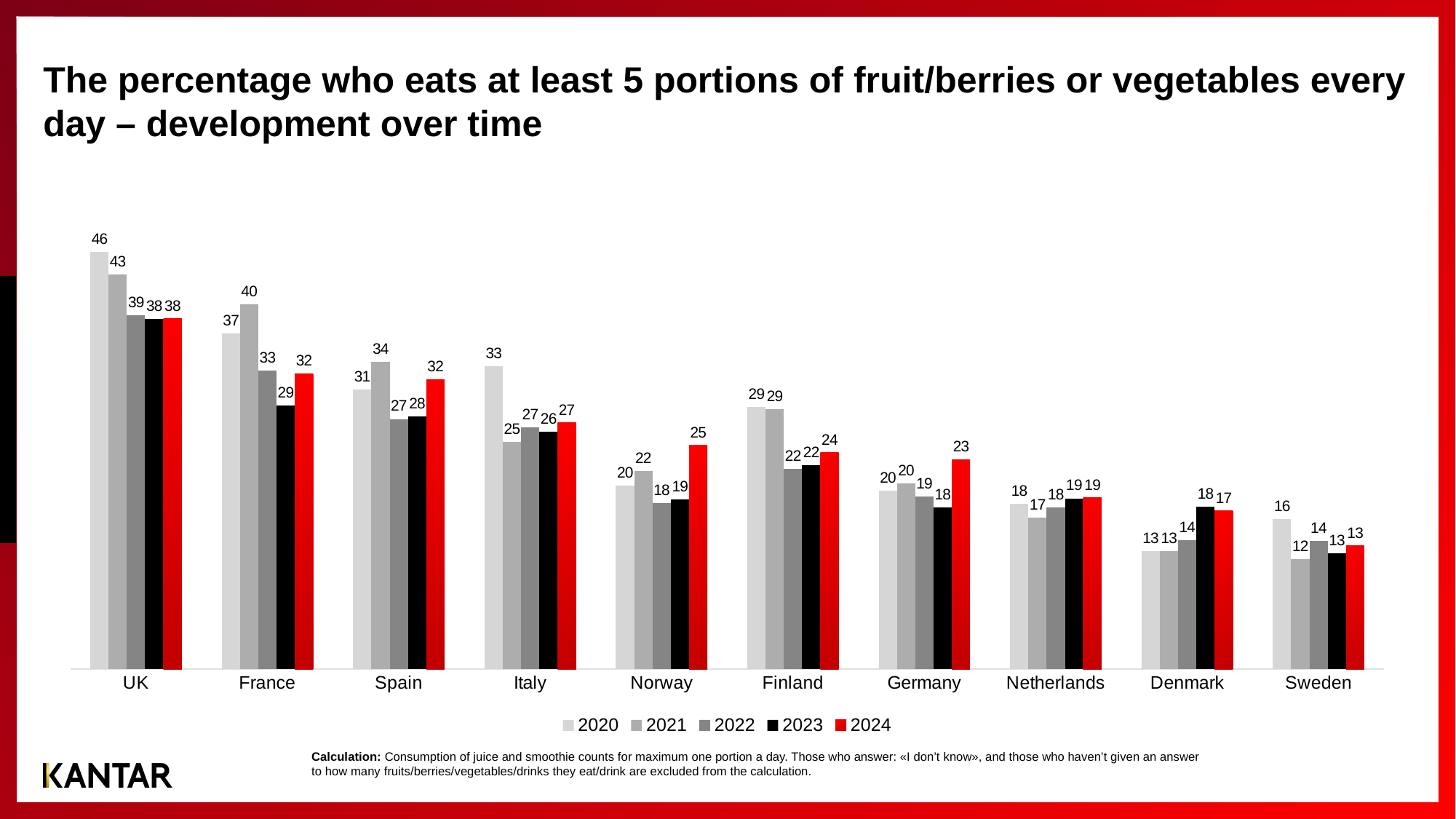
What is the value for Germany in 2023? 18 Do the values for France fall or rise from 2021 to 2023? Fall How many countries are shown on the x axis? 10 What is the value for Norway in 2021? 22 Which country has the highest value in 2020? UK Which is larger: Spain's 2024 value or Italy's 2024 value? Spain's 2024 value Which country has the lowest value in 2021? Sweden Which colour represents the 2024 series in the legend? Red What is the difference between the UK's 2020 value and its 2024 value? 8 What kind of chart is shown on the slide? Bar chart What is the value for the UK in 2024? 38 How many series does the legend list? 5